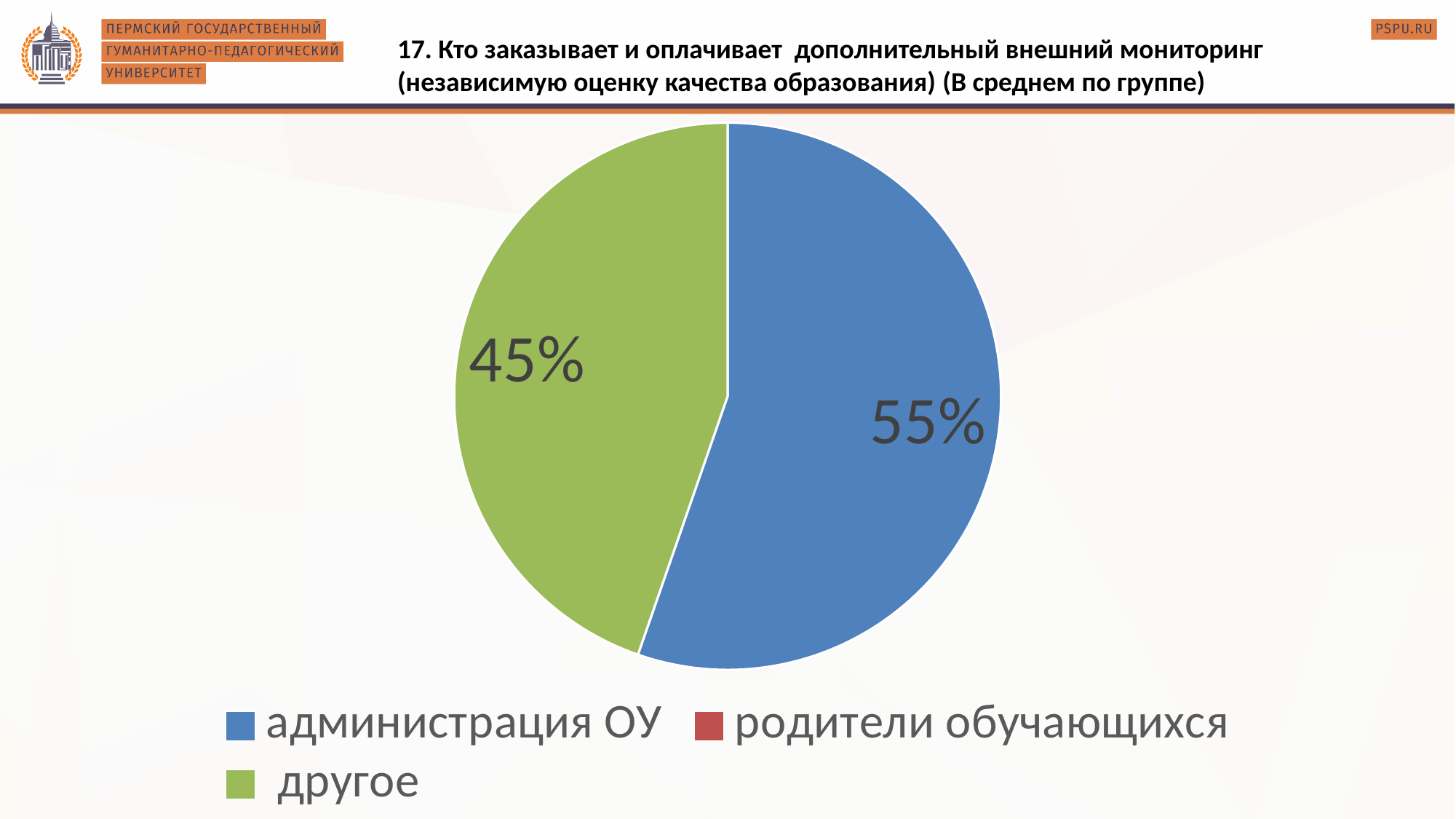
What kind of chart is shown on the slide? pie chart What share of the pie does the slice for другое have? 45% What is the total of the two labelled slices, 55% and 45%? 100% Which of the two visible slices is smaller, администрация ОУ or другое? другое How many slices with a visible percentage label are shown in the pie? 2 How many entries does the legend list? 3 What share of the pie does the slice for администрация ОУ have? 55% Which legend entry is marked with a green square? другое What is the difference in percentage points between the администрация ОУ slice and the другое slice? 10 Which is larger, the slice for администрация ОУ or the slice for другое? администрация ОУ Which category has the largest slice of the pie? администрация ОУ What colour is the slice for администрация ОУ? blue